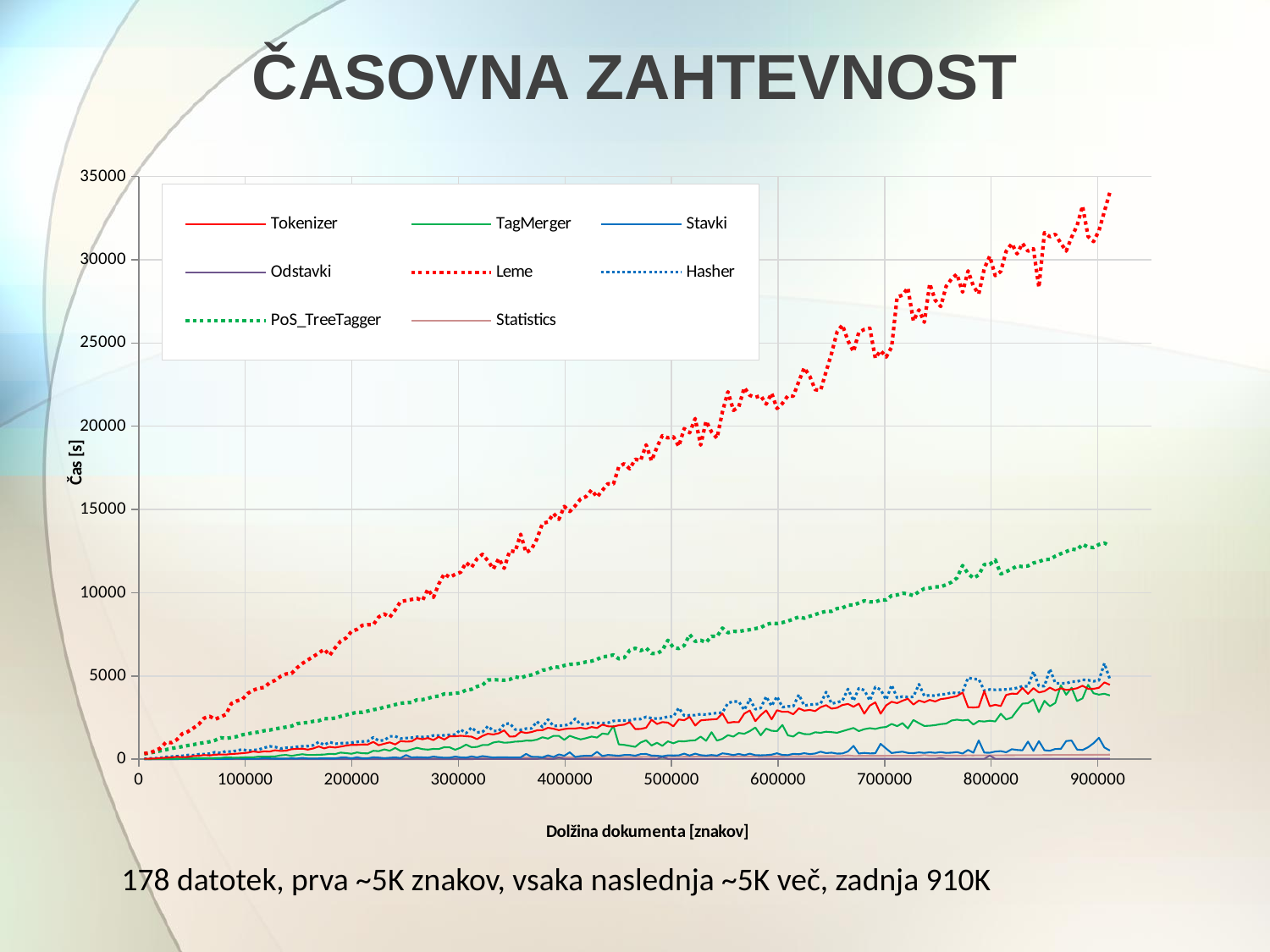
Does the Leme series rise or fall as document length increases along the x axis? rise Is the value for Leme at 900000 characters greater or less than 30000? greater What kind of chart is shown on the slide? line chart What is the label of the vertical axis of the chart? Čas [s] At 900000 characters, which series has the larger value, Leme or PoS_TreeTagger? Leme Is the value for PoS_TreeTagger at 900000 characters greater or less than 15000? less Does the PoS_TreeTagger series rise or fall along the x axis? rise Is the value for Tokenizer at 900000 characters greater or less than 10000? less Which series reaches the highest values on the chart? Leme How many series does the legend list? 8 At 800000 characters, which series has the larger value, PoS_TreeTagger or TagMerger? PoS_TreeTagger